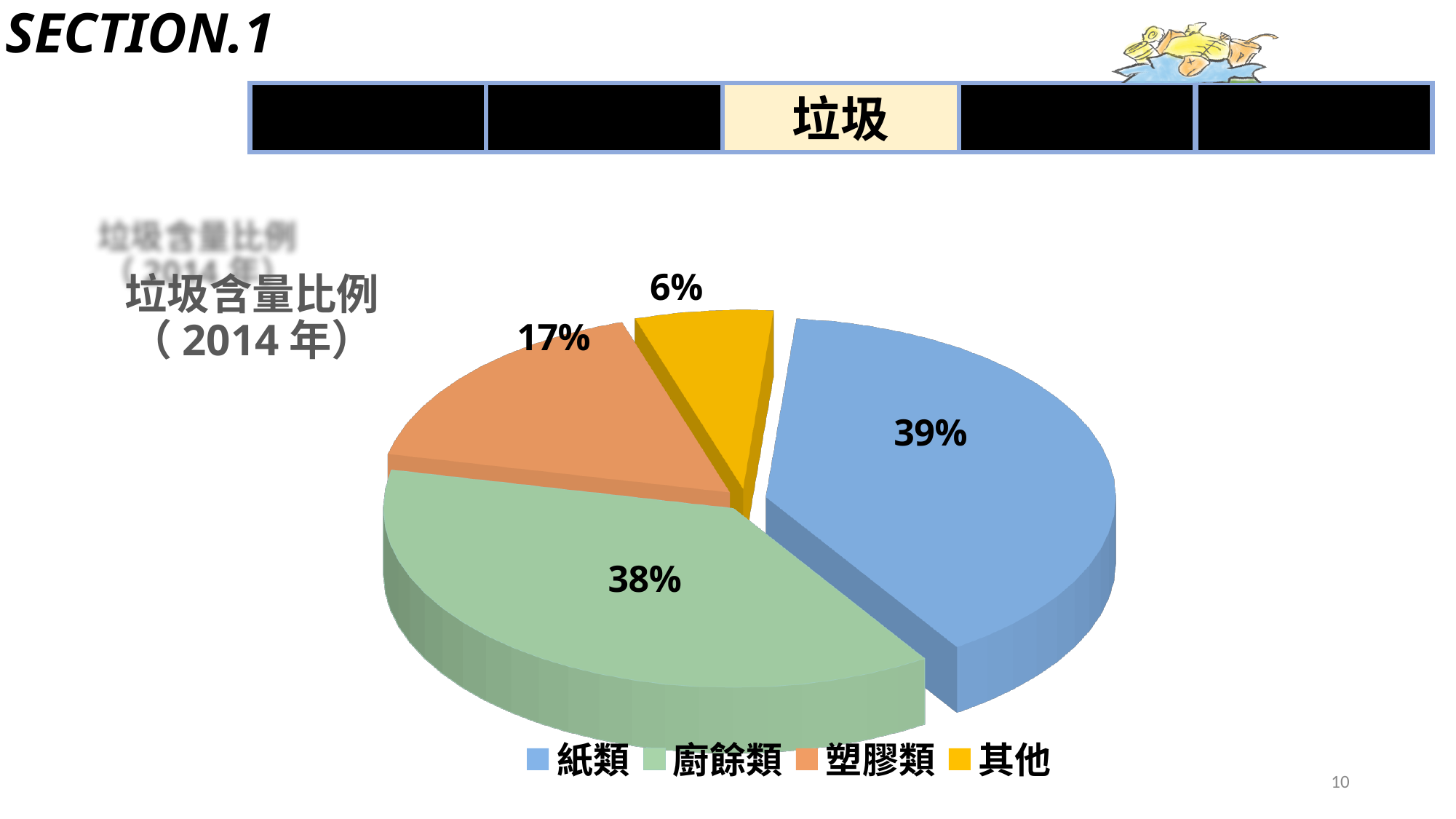
What percentage of the pie is 廚餘類? 38% What percentage of the pie is 其他? 6% Which category has the largest share of the pie? 紙類 Which is larger, the share for 塑膠類 or the share for 其他? 塑膠類 What is the difference in percentage points between 塑膠類 and 其他? 11 What is the difference in percentage points between 紙類 and 廚餘類? 1 What kind of chart is shown on the slide? Pie chart What percentage of the pie is 塑膠類? 17% What is the title of the pie chart? 垃圾含量比例（2014年） Which category has the smallest share of the pie? 其他 How many categories does the pie chart have? 4 What percentage of the pie is 紙類? 39%